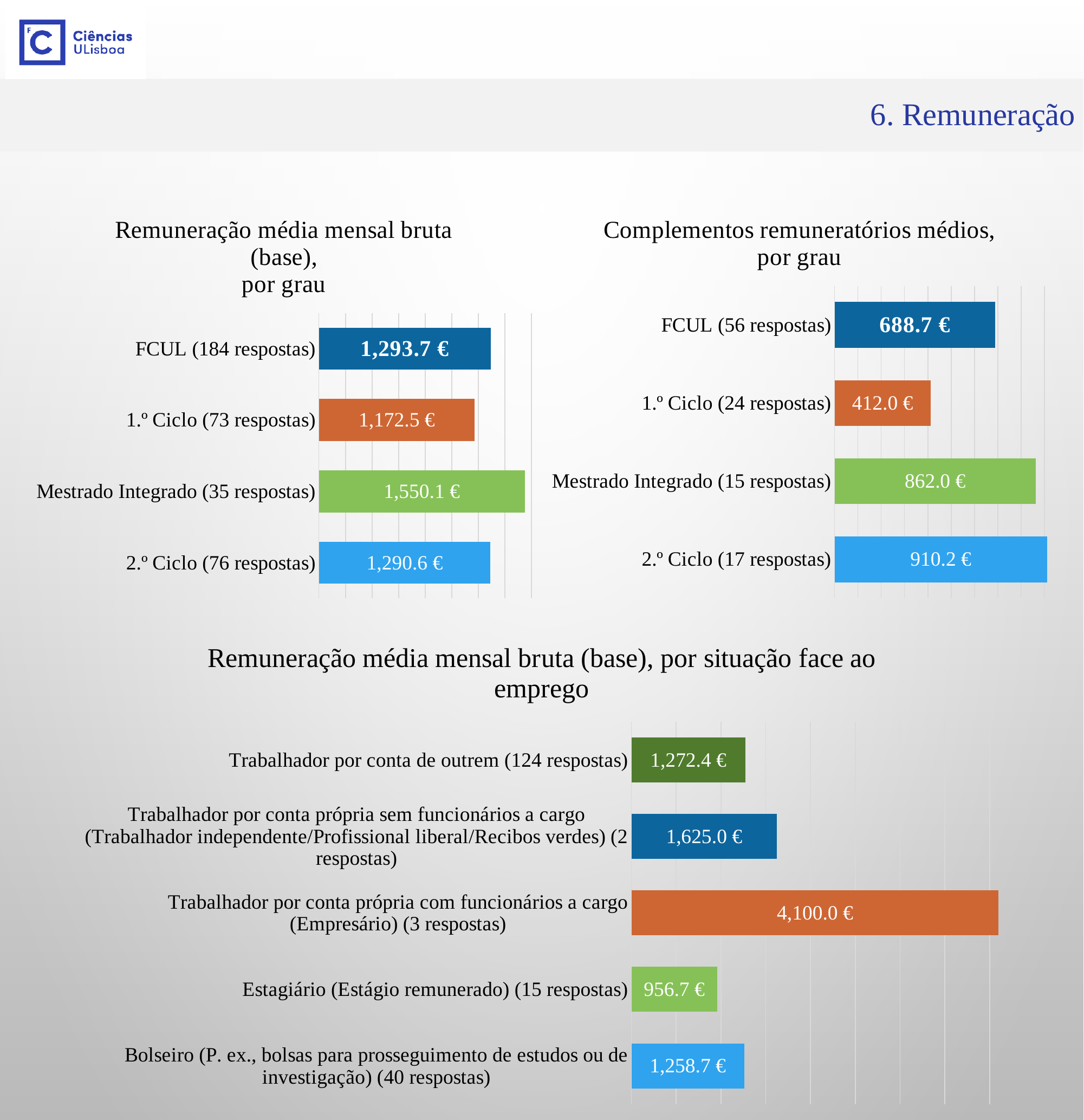
In the chart 'Complementos remuneratórios médios, por grau', what is the difference between 2.º Ciclo and 1.º Ciclo? 498.2 € In the bottom chart 'Remuneração média mensal bruta (base), por situação face ao emprego', which category has the highest value? Trabalhador por conta própria com funcionários a cargo (Empresário) In the bottom chart 'Remuneração média mensal bruta (base), por situação face ao emprego', what is the value for Estagiário (Estágio remunerado)? 956.7 € In the chart 'Complementos remuneratórios médios, por grau', how many categories are shown? 4 In the chart 'Complementos remuneratórios médios, por grau', what is the value for FCUL? 688.7 € In the bottom chart 'Remuneração média mensal bruta (base), por situação face ao emprego', which is larger: Trabalhador por conta de outrem or Bolseiro? Trabalhador por conta de outrem What kind of chart is the bottom chart 'Remuneração média mensal bruta (base), por situação face ao emprego'? Bar chart In the chart 'Complementos remuneratórios médios, por grau', which category has the highest value? 2.º Ciclo In the chart 'Remuneração média mensal bruta (base), por grau', what is the value for Mestrado Integrado? 1,550.1 € In the chart 'Remuneração média mensal bruta (base), por grau', which category has the lowest value? 1.º Ciclo In the chart 'Remuneração média mensal bruta (base), por grau', which category has the highest value? Mestrado Integrado In the chart 'Remuneração média mensal bruta (base), por grau', what is the difference between Mestrado Integrado and 1.º Ciclo? 377.6 €